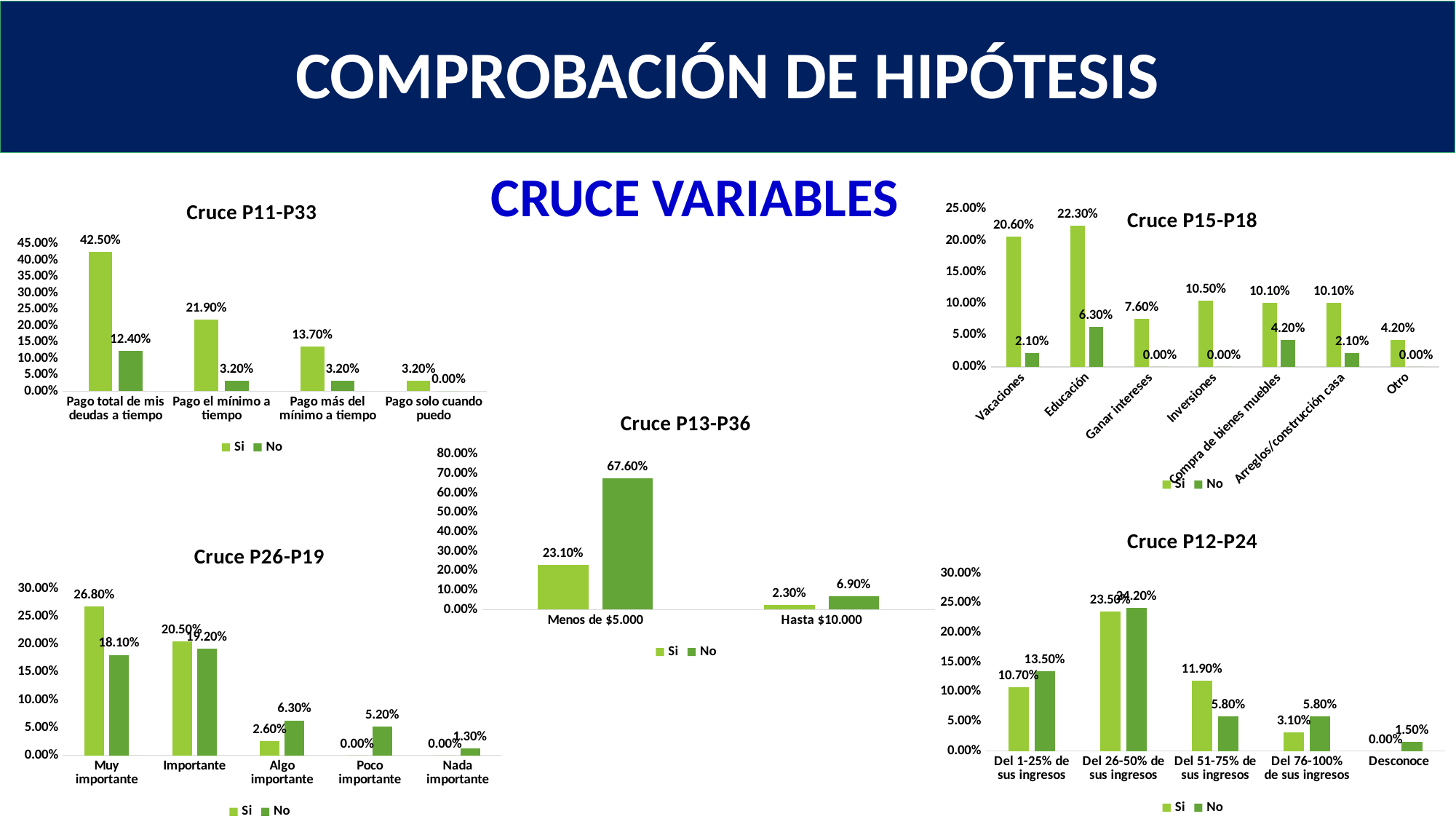
In the Cruce P15-P18 chart, how many categories are shown on the x axis? 7 In the Cruce P26-P19 chart, which is larger for 'Algo importante', the Si value or the No value? No In the Cruce P15-P18 chart, which category has the highest Si value? Educación In the Cruce P13-P36 chart, what is the difference between the No and Si values for 'Menos de $5.000'? 44.50% In the Cruce P11-P33 chart, what is the Si value for 'Pago total de mis deudas a tiempo'? 42.50% In the Cruce P11-P33 chart, what is the No value for 'Pago el mínimo a tiempo'? 3.20% In the Cruce P13-P36 chart, what is the No value for 'Menos de $5.000'? 67.60% In the Cruce P26-P19 chart, what is the Si value for 'Muy importante'? 26.80% In the Cruce P12-P24 chart, what is the Si value for 'Del 51-75% de sus ingresos'? 11.90% In the Cruce P12-P24 chart, which category has the lowest Si value? Desconoce In the Cruce P15-P18 chart, what is the No value for 'Compra de bienes muebles'? 4.20% How many series does the legend of the Cruce P13-P36 chart list? 2